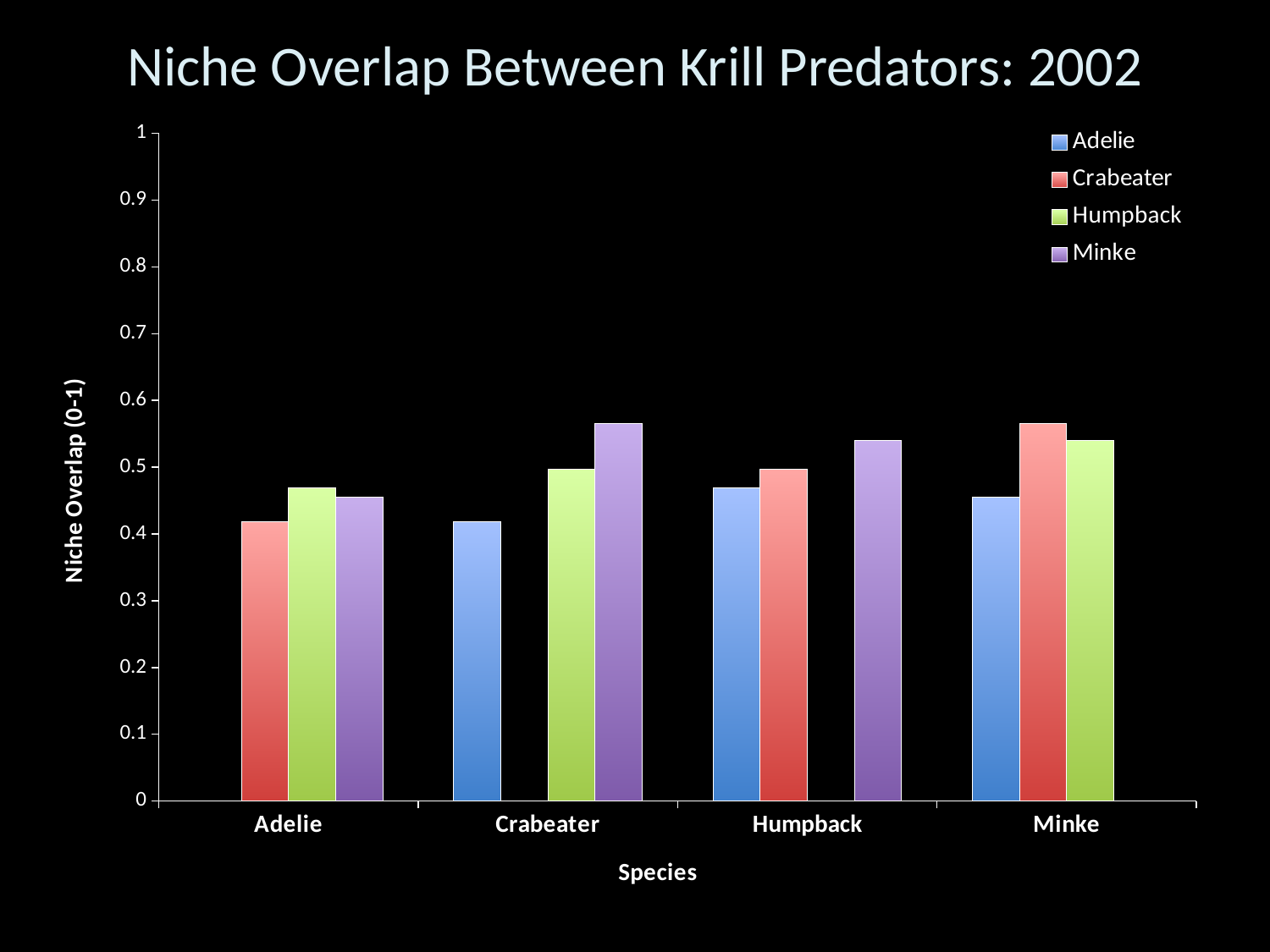
Is the Crabeater bar in the Minke category greater or less than 0.5? greater In the Humpback category, which is larger: the Adelie bar or the Minke bar? Minke Is the Crabeater bar in the Adelie category greater or less than 0.5? less What kind of chart is shown on the slide? bar chart How many species categories are shown on the x axis? 4 Which series has the highest bar in the Crabeater category? Minke What is the label on the y axis? Niche Overlap (0-1) How many series does the legend list? 4 Which series has the lowest bar in the Crabeater category? Adelie What is the title of the chart? Niche Overlap Between Krill Predators: 2002 Is the Adelie bar in the Minke category greater or less than 0.5? less